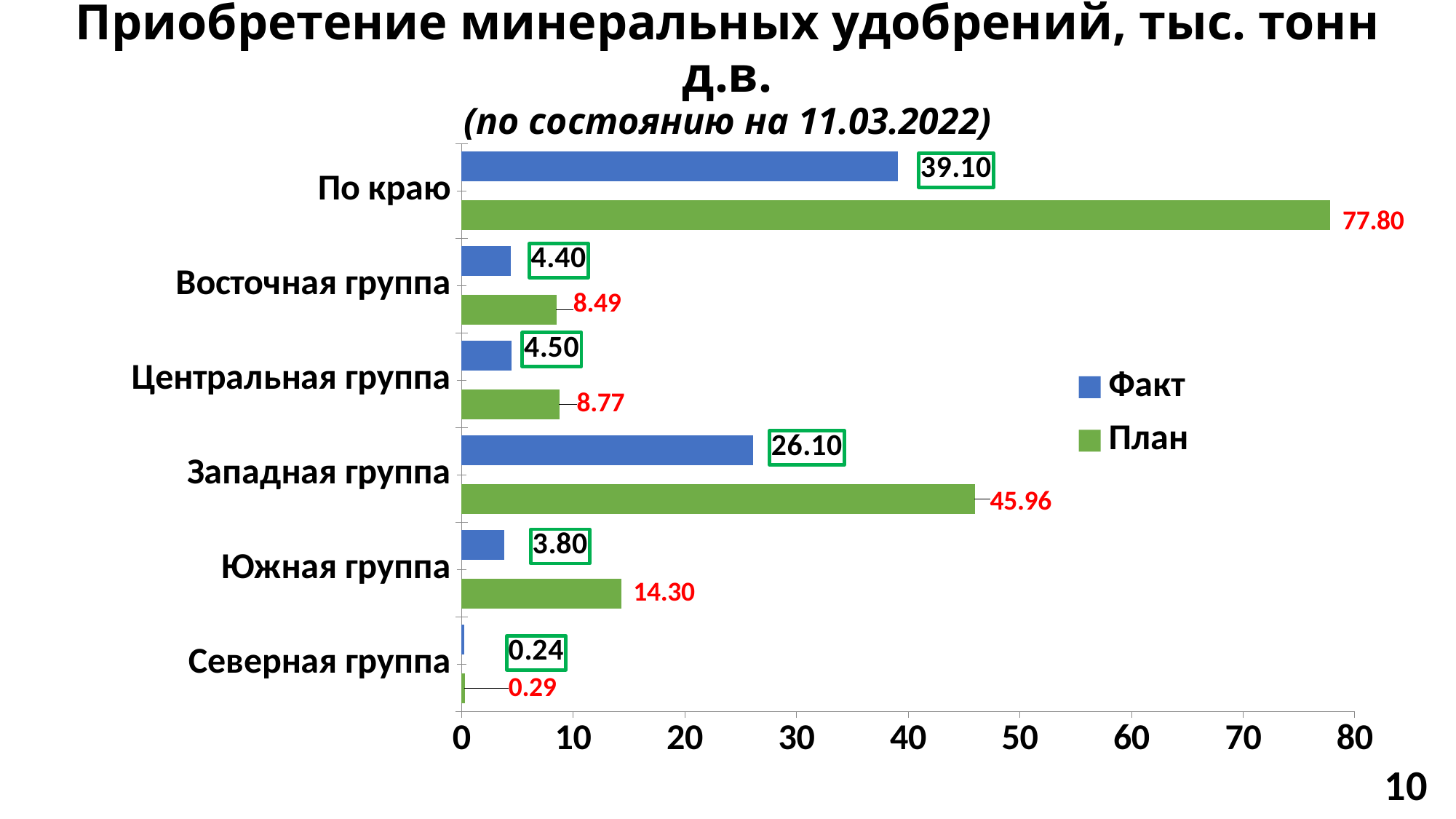
What type of chart is shown on the slide? Bar chart What is the План value for Южная группа? 14.30 Which colour represents the План series in the legend? Green What is the difference between the План and Факт values for По краю? 38.70 How many series does the legend list? 2 What is the План value for По краю? 77.80 Which group (excluding По краю) has the lowest Факт value? Северная группа What is the difference between the План and Факт values for Западная группа? 19.86 What is the Факт value for Западная группа? 26.10 Which group (excluding По краю) has the highest План value? Западная группа How many categories are shown on the vertical axis? 6 Which is larger for Южная группа: the Факт value or the План value? План